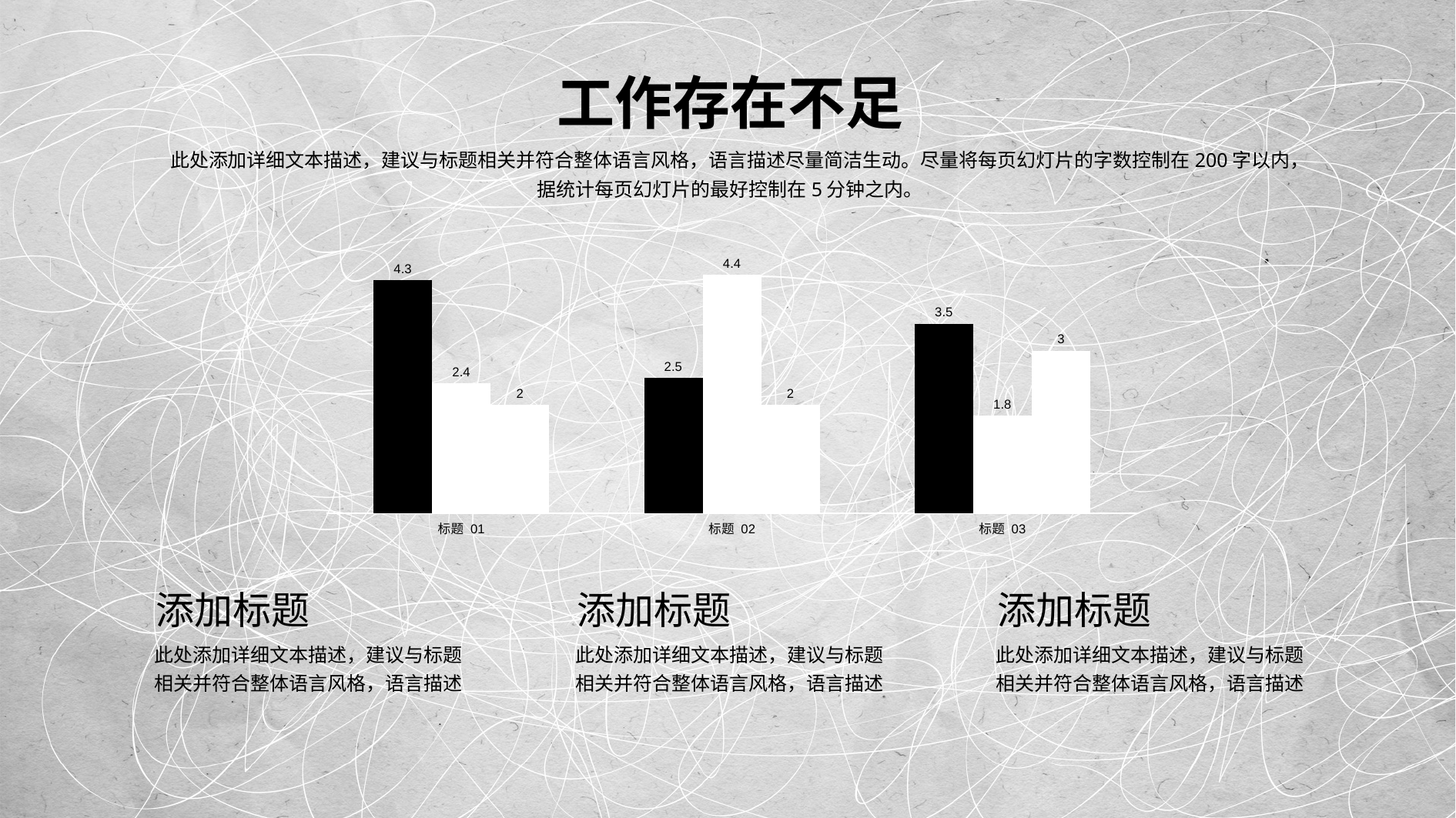
What is the value of the second bar for 标题 03? 1.8 What is the value of the black (first) bar for 标题 01? 4.3 Which is larger: the black bar for 标题 01 or the black bar for 标题 03? 标题 01 What is the value of the third bar for 标题 01? 2 What is the value of the tallest bar for 标题 02? 4.4 Which category contains the lowest bar value in the chart? 标题 03 What kind of chart is shown on the slide? bar chart Which category has the highest single bar value in the chart? 标题 02 How many categories are shown on the x axis of the chart? 3 What is the value of the black (first) bar for 标题 03? 3.5 What is the total of the three bars for 标题 03? 8.3 What is the difference between the black bar for 标题 01 and the black bar for 标题 02? 1.8